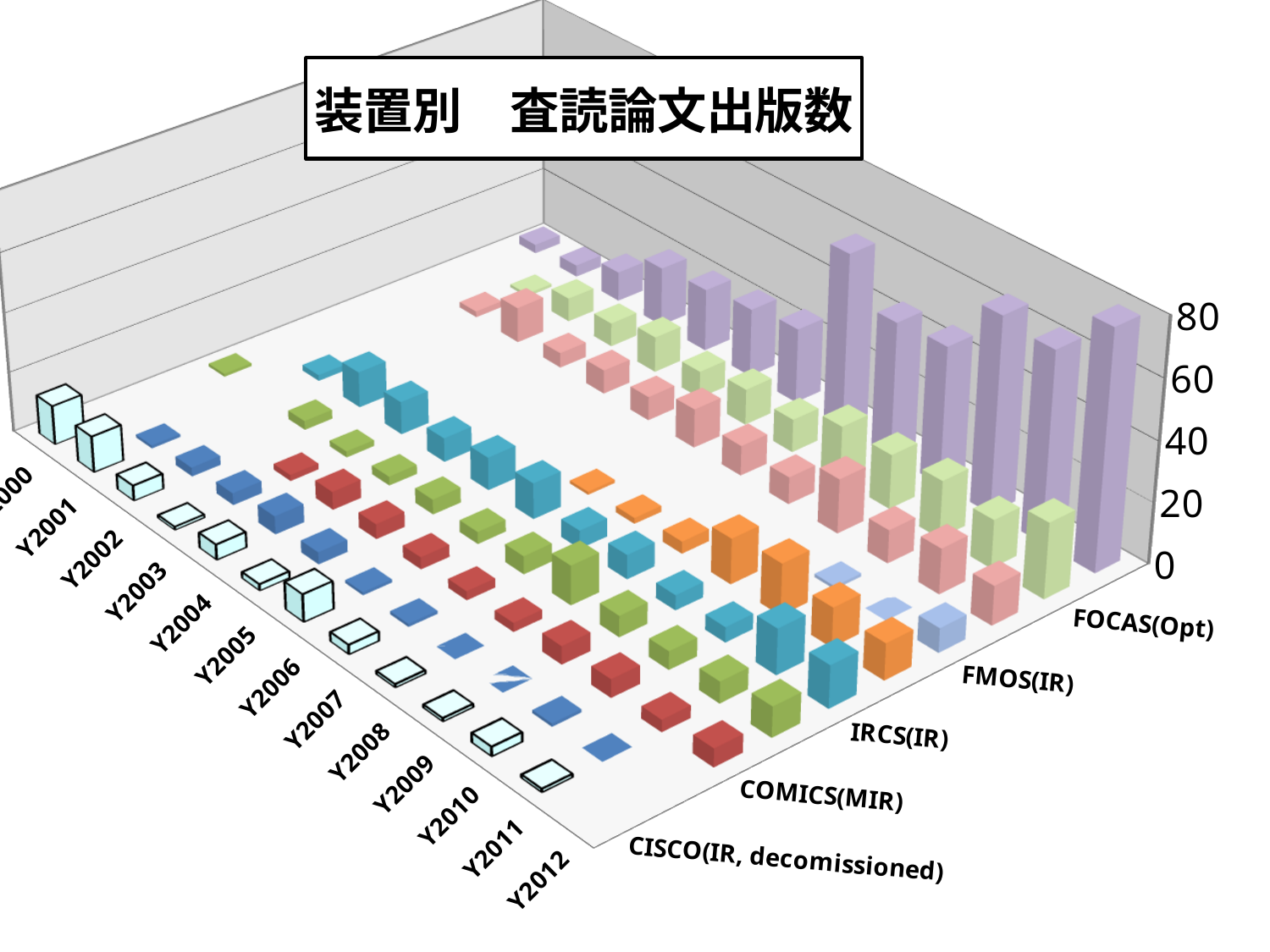
Is the value for COMICS(MIR) in Y2012 greater or less than 20? less Do the values for FOCAS(Opt) generally rise or fall from Y2000 to Y2012? rise Do the values for CISCO(IR, decomissioned) generally rise or fall from Y2000 to Y2012? fall Which instrument is labelled as decommissioned on the chart? CISCO(IR, decomissioned) What is the title of the chart? 装置別 査読論文出版数 How many years are shown along the year axis of the chart? 13 Is the value for FOCAS(Opt) in Y2012 greater or less than 40? less What kind of chart is shown on the slide? bar chart What is the highest tick value shown on the vertical axis? 80